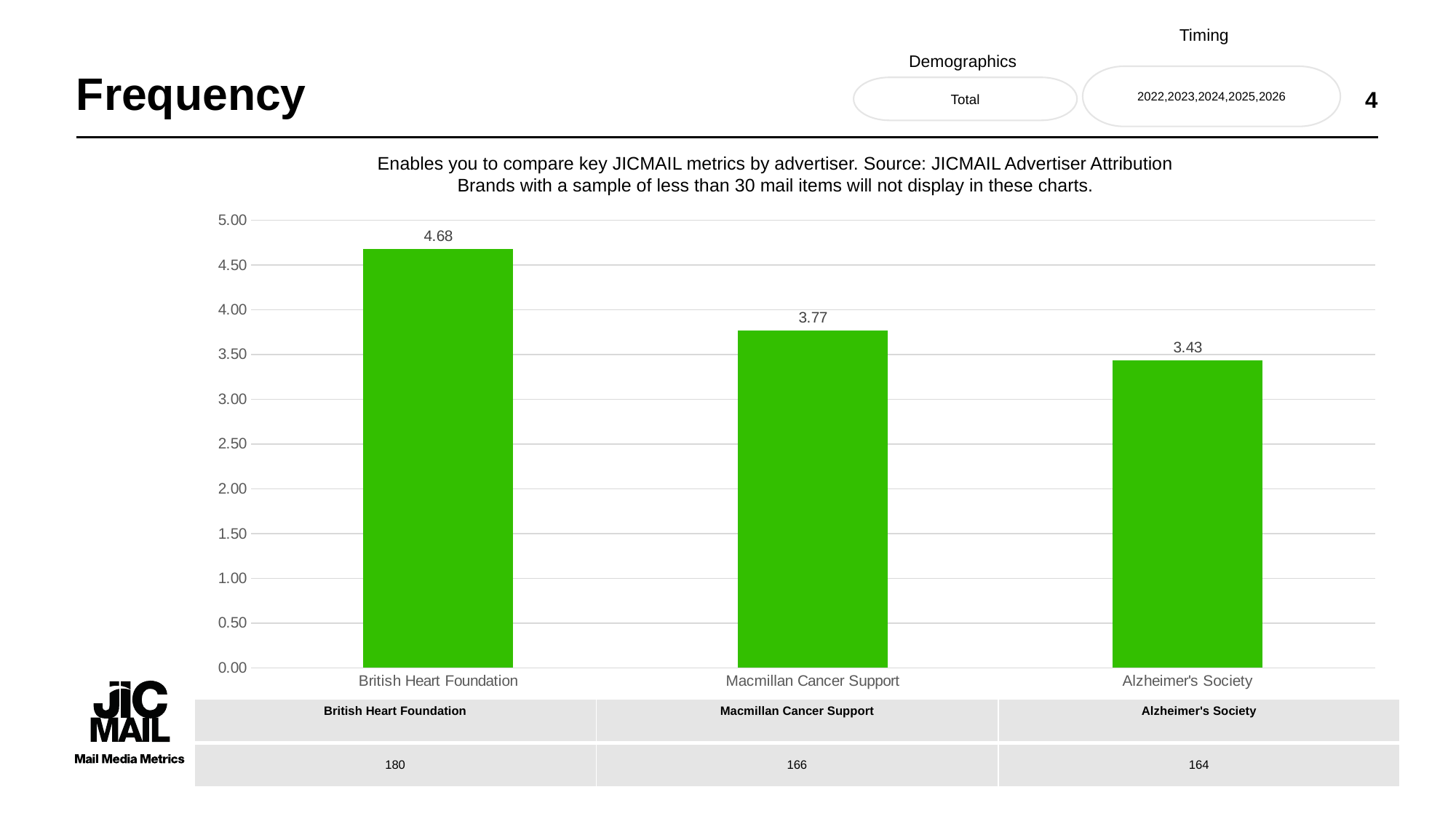
What is the difference between the frequency values for British Heart Foundation and Alzheimer's Society? 1.25 Which advertiser has the lowest frequency value? Alzheimer's Society What is the frequency value for Alzheimer's Society? 3.43 Is the value for Macmillan Cancer Support greater or less than 4.00? less What is the frequency value for British Heart Foundation? 4.68 How many advertisers are shown in the chart? 3 Do the values rise or fall from left to right across the chart? fall What is the difference between the frequency values for Macmillan Cancer Support and Alzheimer's Society? 0.34 What kind of chart is shown on the slide? bar chart Which advertiser has the highest frequency value? British Heart Foundation Which has a higher frequency value, Macmillan Cancer Support or Alzheimer's Society? Macmillan Cancer Support What is the frequency value for Macmillan Cancer Support? 3.77